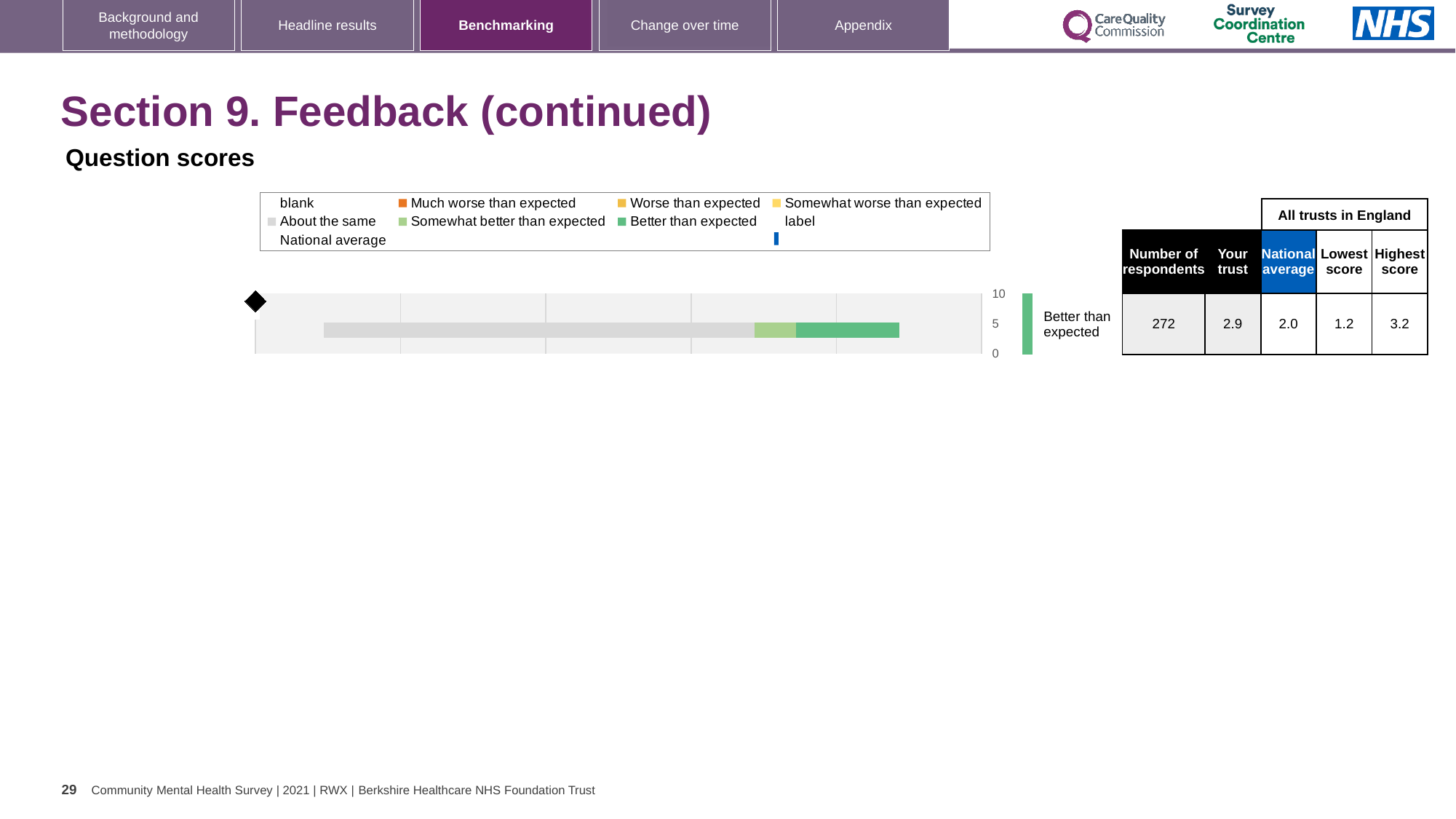
What is the 'Your trust' score shown in the table beside the chart? 2.9 What kind of chart is shown on the slide? bar chart Which colour in the legend represents 'About the same'? grey What is the National average score shown in the table beside the chart? 2.0 What is the difference between the 'Your trust' score and the National average score? 0.9 What is the Highest score among all trusts in England shown in the table? 3.2 What rating label is shown next to the bar in the chart? Better than expected Which is larger, the 'Your trust' score or the National average score? Your trust What is the Lowest score among all trusts in England shown in the table? 1.2 How many bars (categories) are plotted in the chart? 1 What is the Number of respondents shown in the table beside the chart? 272